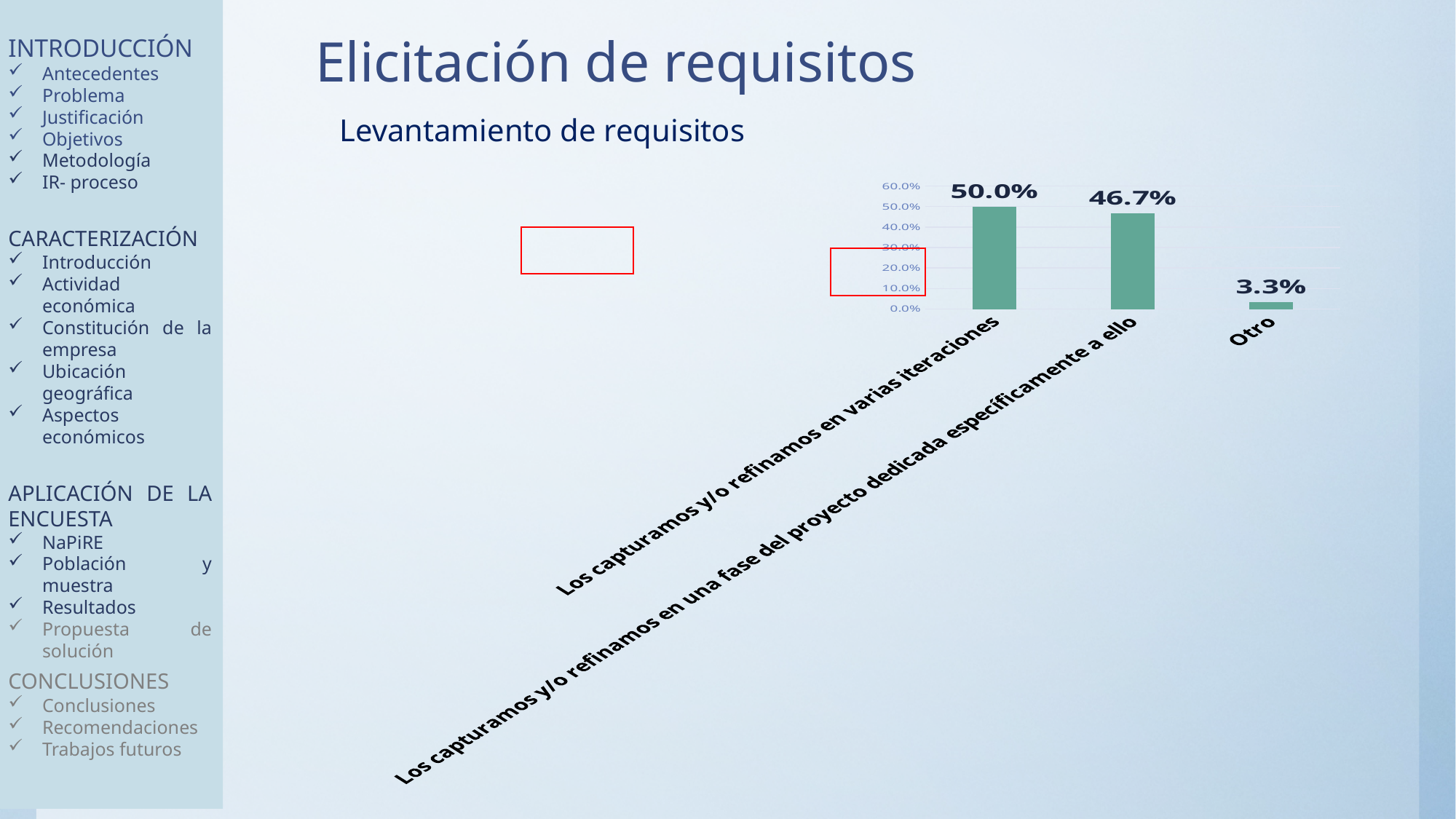
Do the values rise or fall from left to right along the x axis? fall What is the value for "Otro"? 3.3% Is the value for "Otro" greater or less than 10.0%? less Which category has the lowest value? Otro What is the difference between the values for "Los capturamos y/o refinamos en varias iteraciones" and "Los capturamos y/o refinamos en una fase del proyecto dedicada específicamente a ello"? 3.3% What is the highest value shown on the vertical axis? 60.0% Which is larger: the value for "Los capturamos y/o refinamos en una fase del proyecto dedicada específicamente a ello" or the value for "Otro"? Los capturamos y/o refinamos en una fase del proyecto dedicada específicamente a ello What is the value for "Los capturamos y/o refinamos en varias iteraciones"? 50.0% How many categories are shown in the chart? 3 What is the value for "Los capturamos y/o refinamos en una fase del proyecto dedicada específicamente a ello"? 46.7% Which category has the highest value? Los capturamos y/o refinamos en varias iteraciones What kind of chart is shown on the slide? bar chart